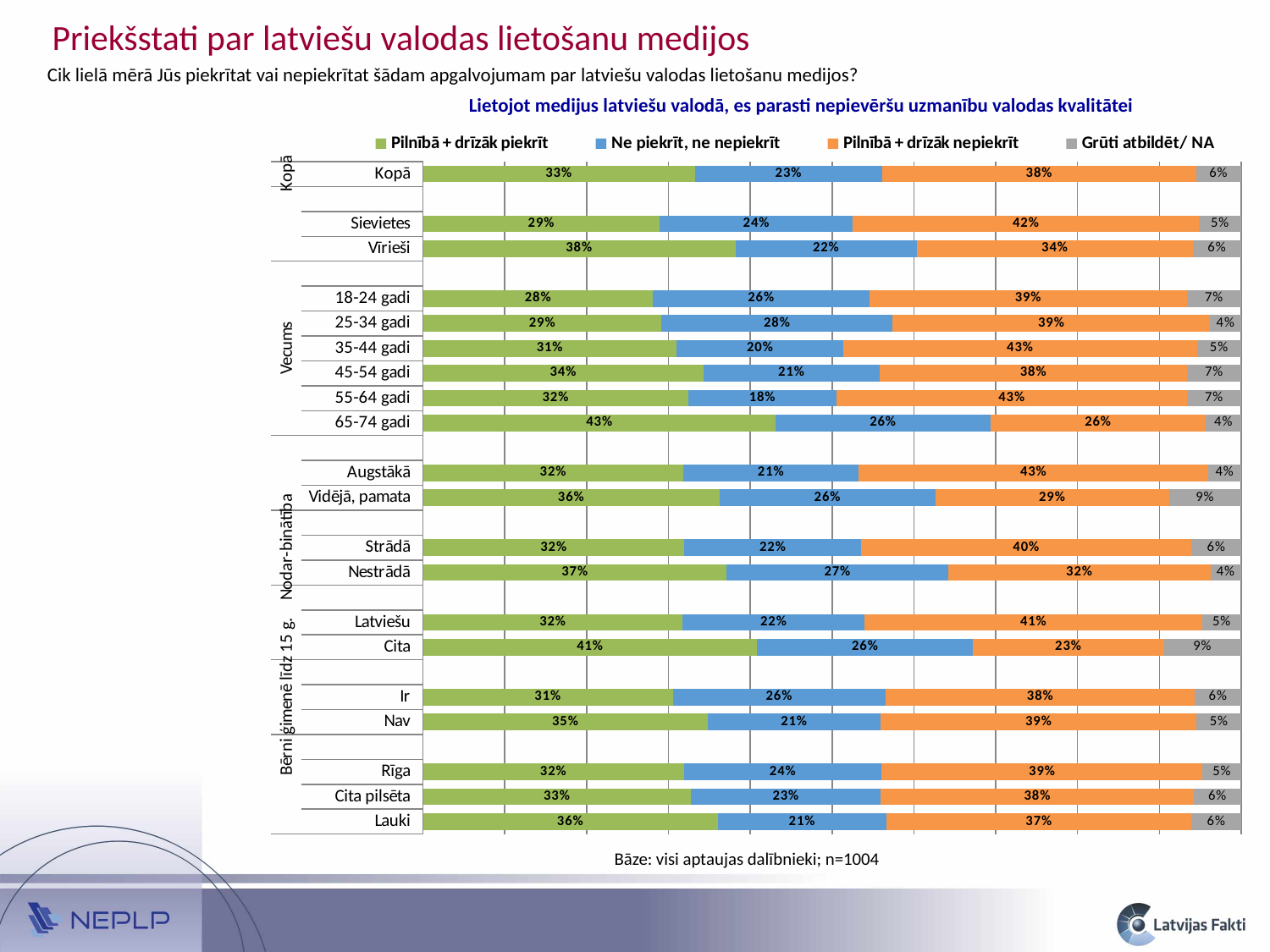
What is the difference between the "Pilnībā + drīzāk nepiekrīt" values for Sievietes and Vīrieši? 8% Which has a larger "Pilnībā + drīzāk piekrīt" value, Strādā or Nestrādā? Nestrādā Which category has the lowest "Pilnībā + drīzāk piekrīt" value? 18-24 gadi What percentage of Sievietes chose "Pilnībā + drīzāk piekrīt"? 29% Which category has the lowest "Ne piekrīt, ne nepiekrīt" value? 55-64 gadi What is the "Pilnībā + drīzāk nepiekrīt" value for 35-44 gadi? 43% How many categories are plotted on the chart? 20 What kind of chart is shown on the slide? Stacked bar chart What is the "Grūti atbildēt/ NA" value for Vidējā, pamata? 9% How many series does the legend list? 4 Which category has the highest "Pilnībā + drīzāk piekrīt" value? 65-74 gadi What is the total of the stacked bar for Kopā? 100%